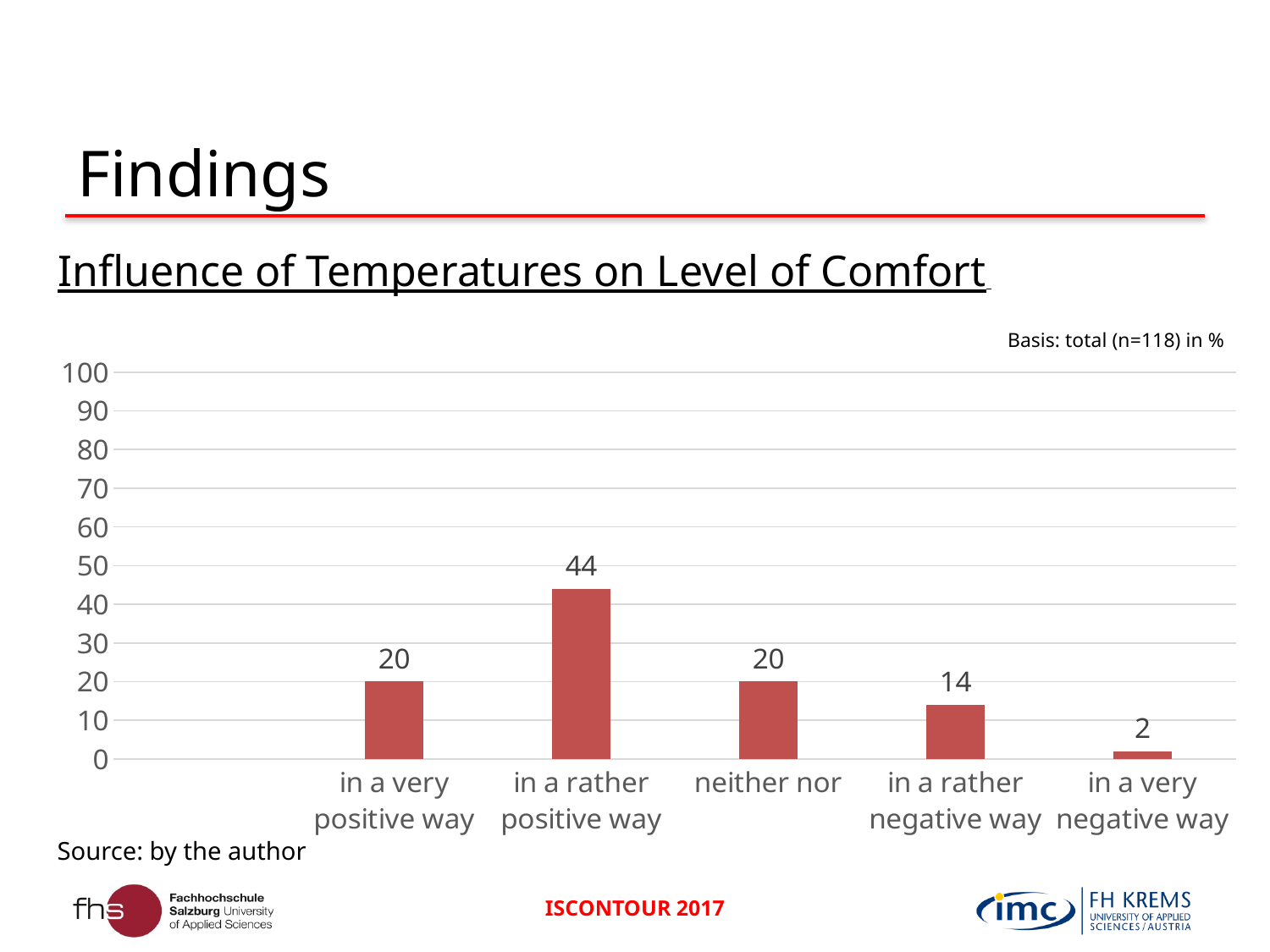
What is the value for "in a rather positive way"? 44 Which category has the lowest value? in a very negative way Which is larger, the value for "in a rather negative way" or the value for "in a very negative way"? in a rather negative way How many categories are shown on the x axis? 5 What is the value for "in a rather negative way"? 14 What kind of chart is shown on the slide? bar chart What is the value for "in a very negative way"? 2 What is the difference between the values for "in a rather positive way" and "in a rather negative way"? 30 Is the value for "in a rather positive way" greater or less than 40? greater What is the basis noted above the chart? total (n=118) in % What is the title of the chart? Influence of Temperatures on Level of Comfort Which category has the highest value? in a rather positive way